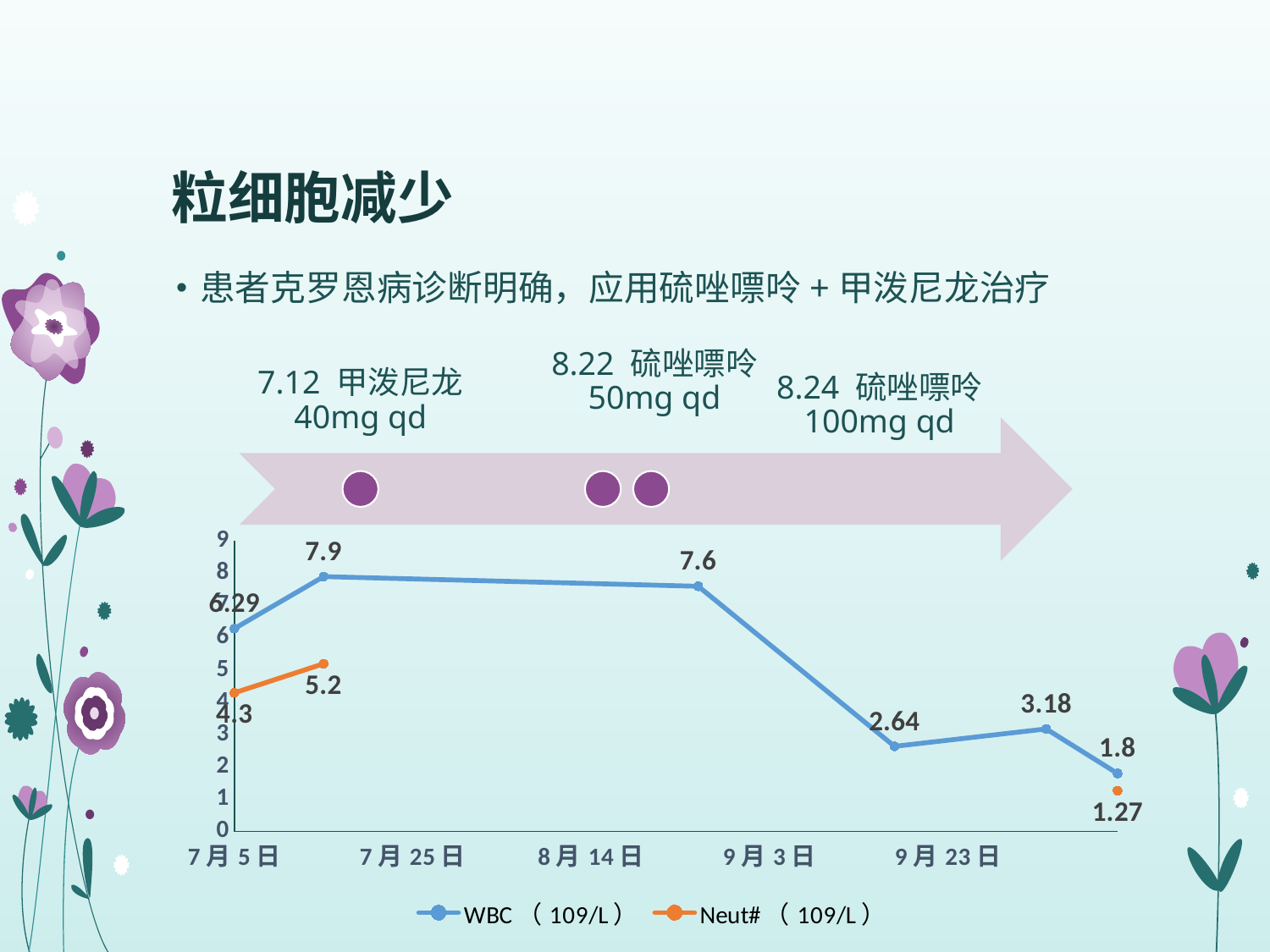
What is the highest labelled value of the WBC series? 7.9 What is the lowest labelled value of the WBC series? 1.8 At the last date, which is larger: the WBC value (1.8) or the Neut# value (1.27)? WBC How many data points are plotted for the Neut# series? 3 Which colour is used for the Neut# series line? orange Does the WBC series rise or fall from the point labelled 7.6 to the point labelled 1.8? fall What is the difference between the WBC values labelled 7.9 and 7.6? 0.3 What type of chart is shown on the slide? line chart How many series does the chart legend list? 2 What is the lowest labelled value of the Neut# series? 1.27 How many data points are plotted for the WBC series? 6 What is the difference between the WBC values labelled 3.18 and 2.64? 0.54